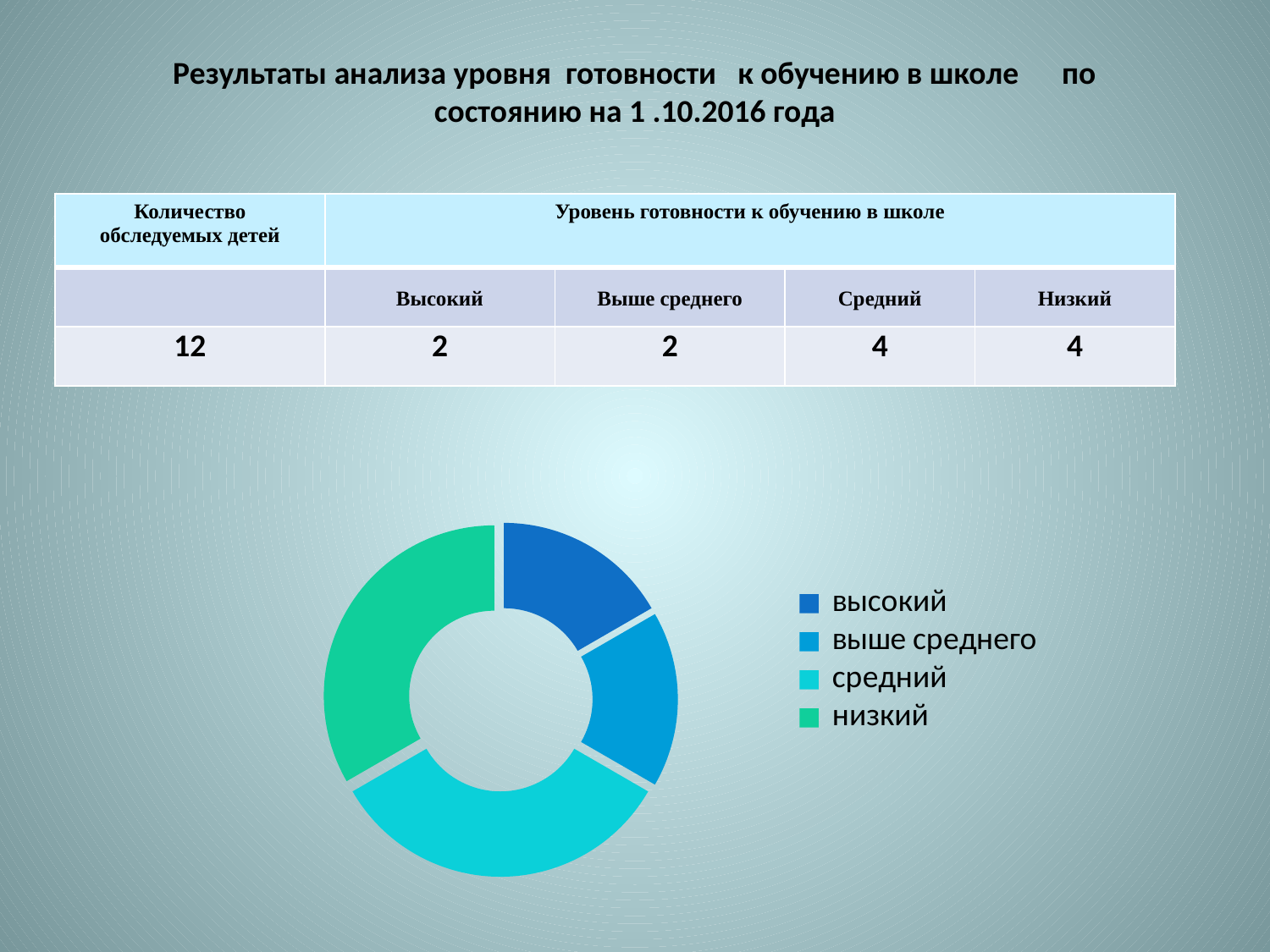
Which legend entry is shown in green? низкий What is the difference between the values for 'средний' and 'высокий'? 2 How many categories does the doughnut chart show? 4 What is the value for the category 'выше среднего' in the chart? 2 What is the value for the category 'средний' in the chart? 4 Which slice is larger, 'низкий' or 'высокий'? низкий How many entries does the chart legend list? 4 What is the total number of children represented in the chart? 12 What is the value for the category 'низкий' in the chart? 4 Which slice is larger, 'средний' or 'выше среднего'? средний What is the value for the category 'высокий' in the chart? 2 What kind of chart is shown on the slide? Doughnut (pie) chart